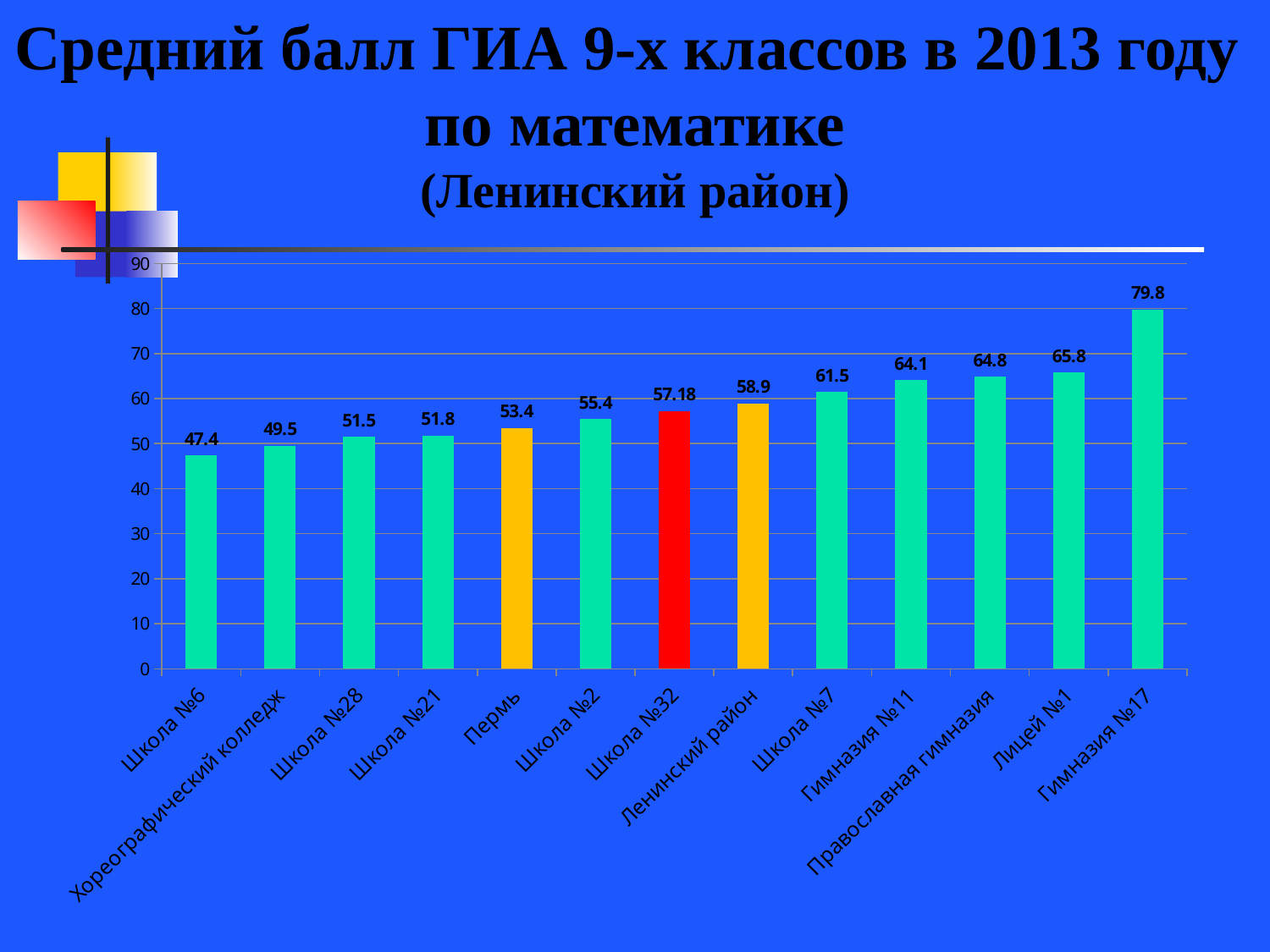
Which category has the highest value? Гимназия №17 Which is larger, the value for Школа №7 or the value for Школа №2? Школа №7 Is the value for Гимназия №11 greater or less than 60? greater Do the values rise or fall from left to right along the x axis? rise What kind of chart is shown on the slide? bar chart How many categories are shown on the x axis? 13 Which category has the lowest value? Школа №6 What is the value for Школа №32? 57.18 What is the difference between the values for Ленинский район and Пермь? 5.5 What is the difference between the values for Гимназия №17 and Лицей №1? 14 What is the value for Пермь? 53.4 What is the value for Ленинский район? 58.9